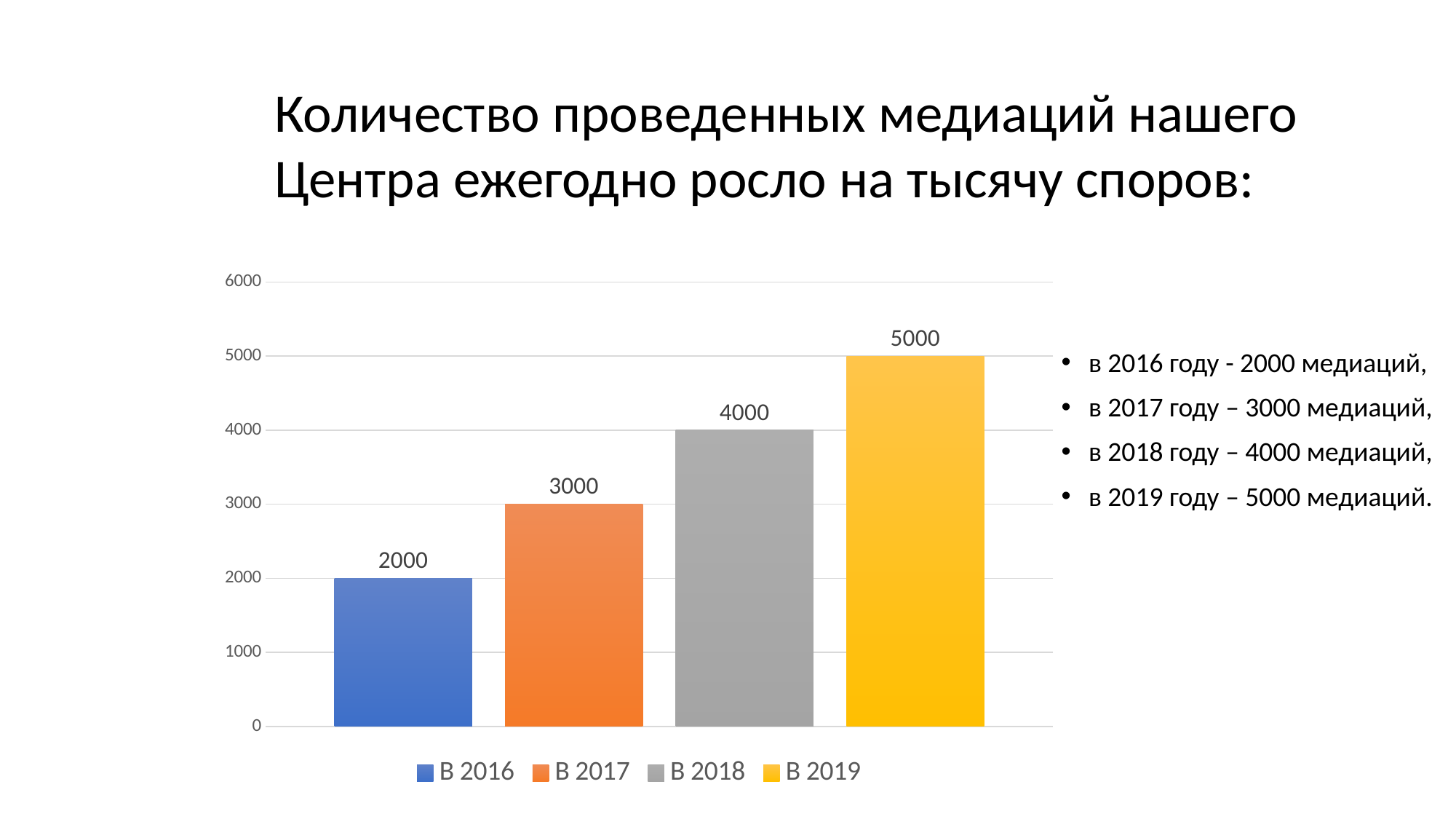
Is the value for В 2017 greater or less than 2000? greater What is the value of the bar for В 2018? 4000 How many entries does the legend list? 4 How many bars are plotted in the chart? 4 What is the value of the bar for В 2019? 5000 What kind of chart is shown on the slide? bar chart Which is larger, the value for В 2017 or the value for В 2018? В 2018 Do the values rise or fall from В 2016 to В 2019? rise Which year has the highest bar? В 2019 Which year has the lowest bar? В 2016 What is the difference between the values for В 2019 and В 2017? 2000 What is the value of the bar for В 2016? 2000